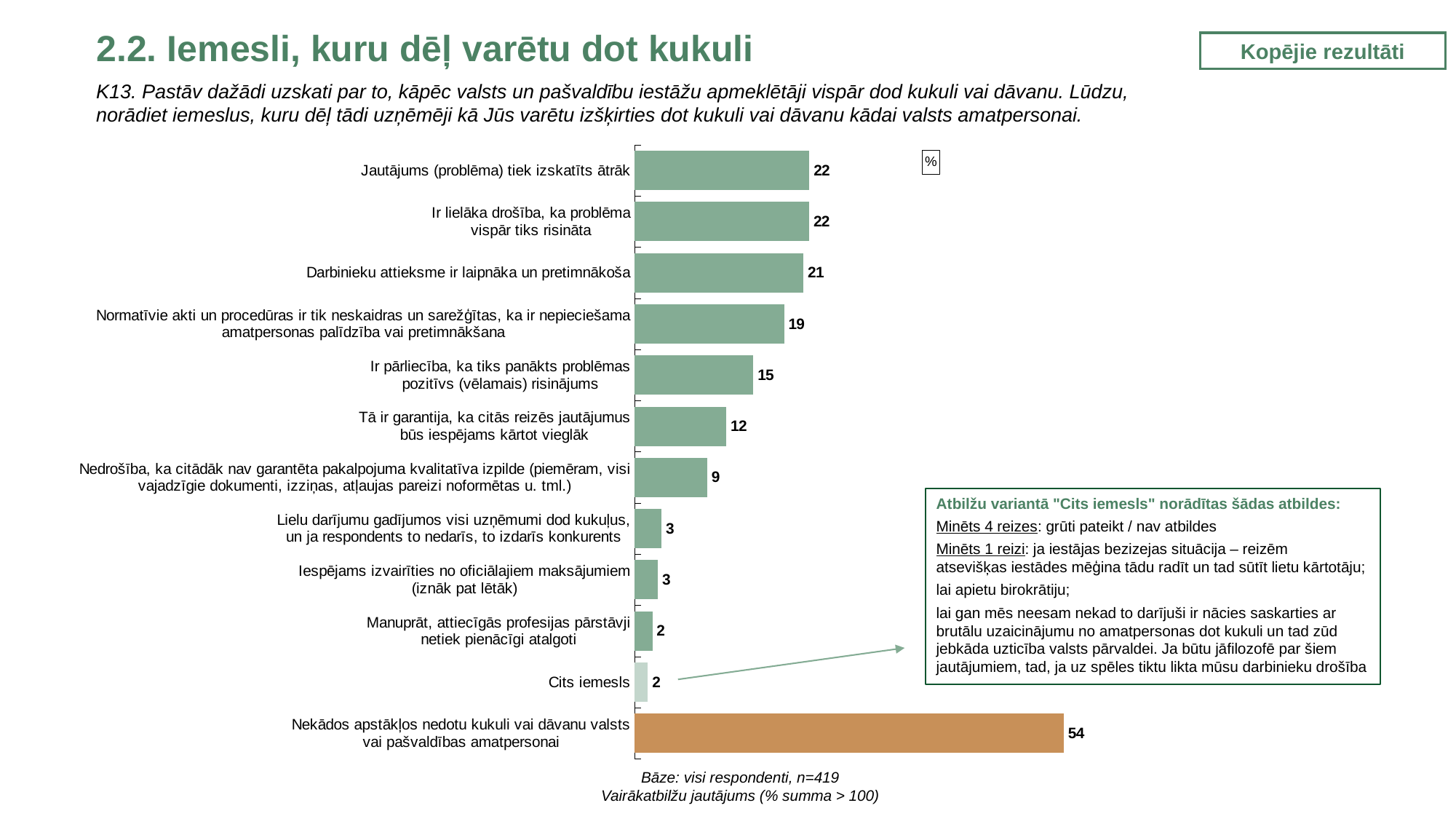
What is the difference between the value for "Darbinieku attieksme ir laipnāka un pretimnākoša" and the value for "Tā ir garantija, ka citās reizēs jautājumus būs iespējams kārtot vieglāk"? 9 Which is larger: the value for "Normatīvie akti un procedūras ir tik neskaidras un sarežģītas, ka ir nepieciešama amatpersonas palīdzība vai pretimnākšana" or the value for "Nedrošība, ka citādāk nav garantēta pakalpojuma kvalitatīva izpilde"? Normatīvie akti un procedūras ir tik neskaidras un sarežģītas, ka ir nepieciešama amatpersonas palīdzība vai pretimnākšana What is the base (n) of respondents stated below the chart? n=419 Which category has the highest value? Nekādos apstākļos nedotu kukuli vai dāvanu valsts vai pašvaldības amatpersonai What is the value for "Jautājums (problēma) tiek izskatīts ātrāk"? 22 What is the difference between the value for "Nekādos apstākļos nedotu kukuli vai dāvanu valsts vai pašvaldības amatpersonai" and the value for "Jautājums (problēma) tiek izskatīts ātrāk"? 32 How many categories (bars) does the chart show? 12 What kind of chart is shown on the slide? Bar chart What is the value for "Ir pārliecība, ka tiks panākts problēmas pozitīvs (vēlamais) risinājums"? 15 What is the value for "Darbinieku attieksme ir laipnāka un pretimnākoša"? 21 What is the value for "Cits iemesls"? 2 What is the value for "Nekādos apstākļos nedotu kukuli vai dāvanu valsts vai pašvaldības amatpersonai"? 54